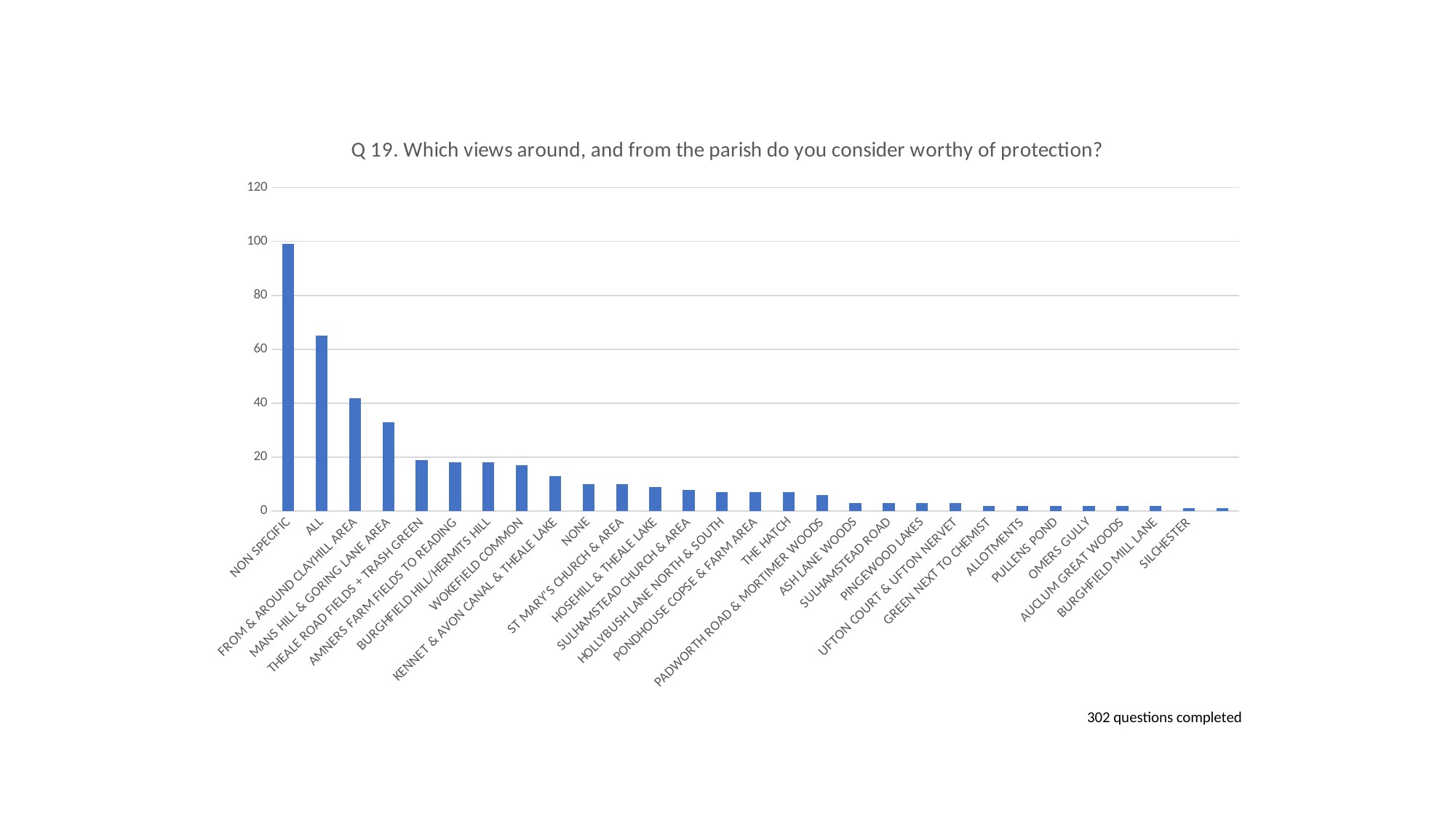
Is the value for WOKEFIELD COMMON greater or less than 40? less Is the value for MANS HILL & GORING LANE AREA greater or less than 40? less Is the value for ALL greater or less than 60? greater What kind of chart is shown on the slide? bar chart What is the title of the chart? Q 19. Which views around, and from the parish do you consider worthy of protection? Which category has the highest value? NON SPECIFIC Which is larger, the value for ALL or the value for FROM & AROUND CLAYHILL AREA? ALL Do the values generally rise or fall moving from left to right along the x axis? fall Which is larger, the value for NON SPECIFIC or the value for ALL? NON SPECIFIC